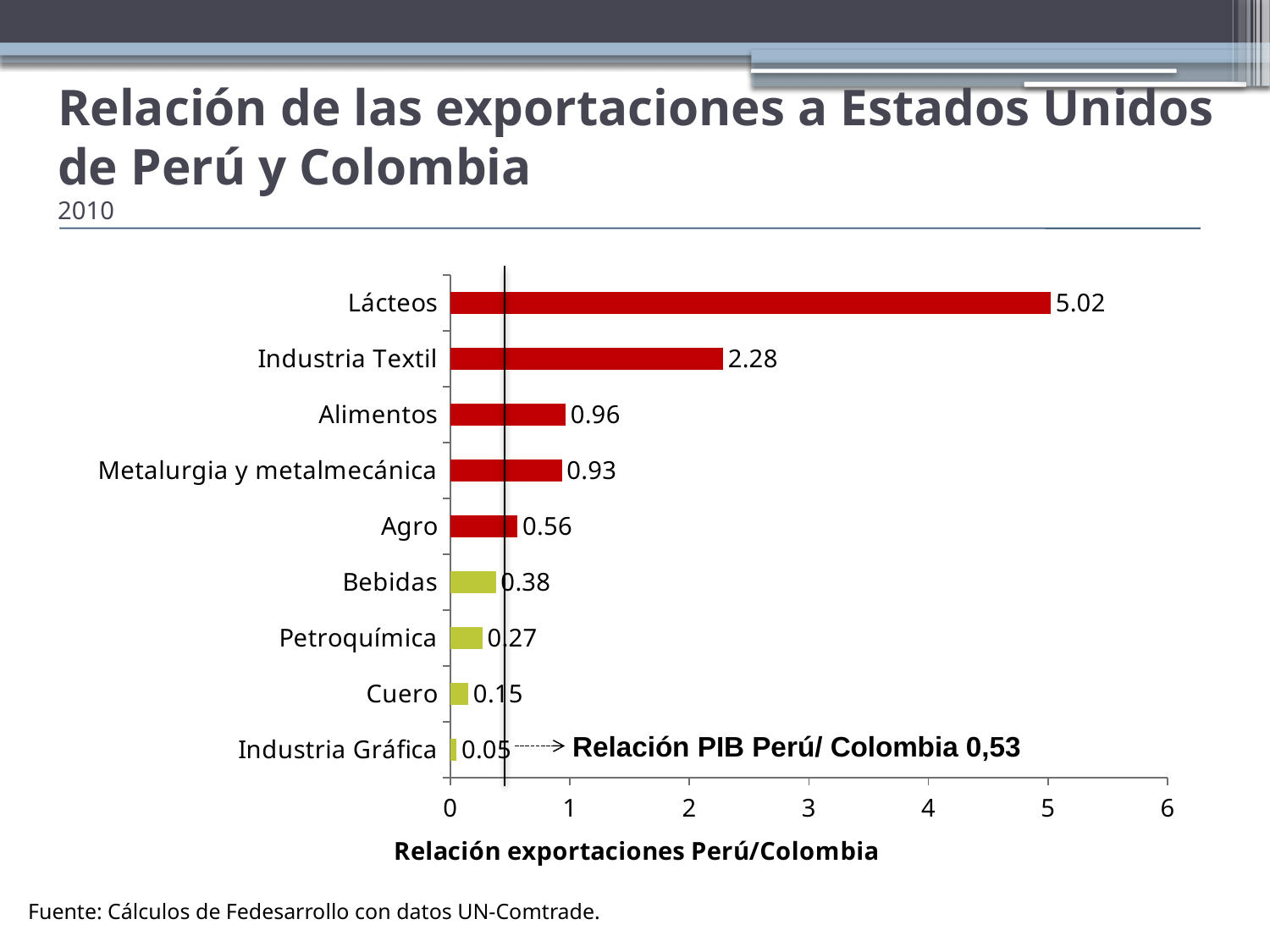
What is the value for Lácteos? 5.02 What is the value for Industria Textil? 2.28 Is the value for Industria Textil greater or less than 2? greater What is the label of the horizontal axis? Relación exportaciones Perú/Colombia Which category has the lowest value? Industria Gráfica How many categories are shown in the chart? 9 What is the difference between the values for Lácteos and Industria Textil? 2.74 What is the value for Metalurgia y metalmecánica? 0.93 Which is larger, the value for Agro or the value for Bebidas? Agro What kind of chart is shown on the slide? bar chart Which category has the highest value? Lácteos What is the value for Cuero? 0.15